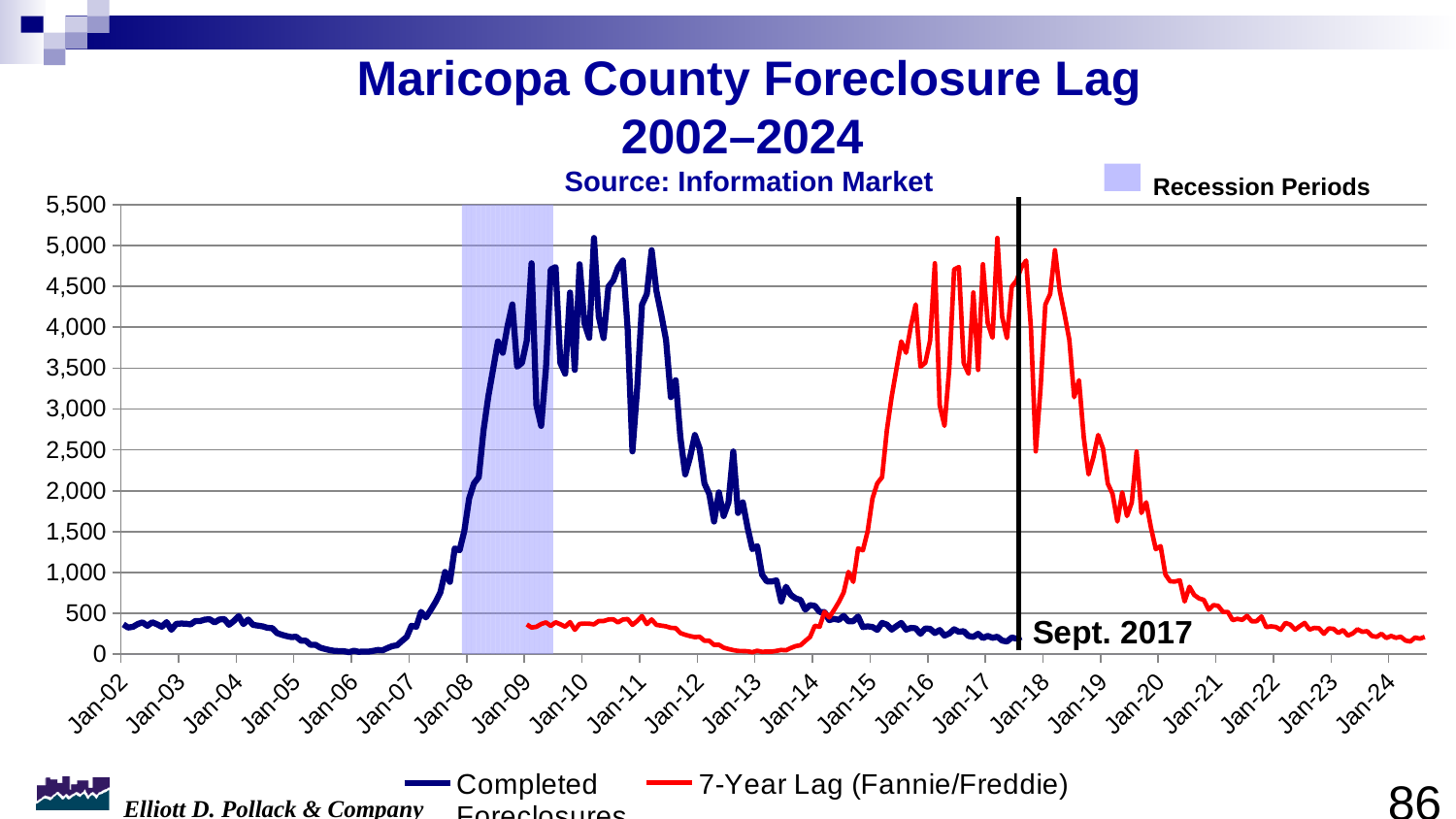
Is the value for Completed Foreclosures at Jan-10 greater or less than 3,000? greater What is the title of the chart? Maricopa County Foreclosure Lag 2002–2024 At Jan-10, which series has the higher value, Completed Foreclosures or 7-Year Lag (Fannie/Freddie)? Completed Foreclosures What does the shaded blue band on the chart represent? Recession Periods Is the value for Completed Foreclosures at Jan-06 greater or less than 500? less Is the value for the 7-Year Lag (Fannie/Freddie) series at Jan-17 greater or less than 3,000? greater Do the 7-Year Lag (Fannie/Freddie) values rise or fall between Jan-14 and Jan-16? rise Do the Completed Foreclosures values rise or fall between Jan-11 and Jan-14? fall What kind of chart is shown on the slide? line chart How many data series does the legend list? 2 At Jan-16, which series has the higher value, Completed Foreclosures or 7-Year Lag (Fannie/Freddie)? 7-Year Lag (Fannie/Freddie)